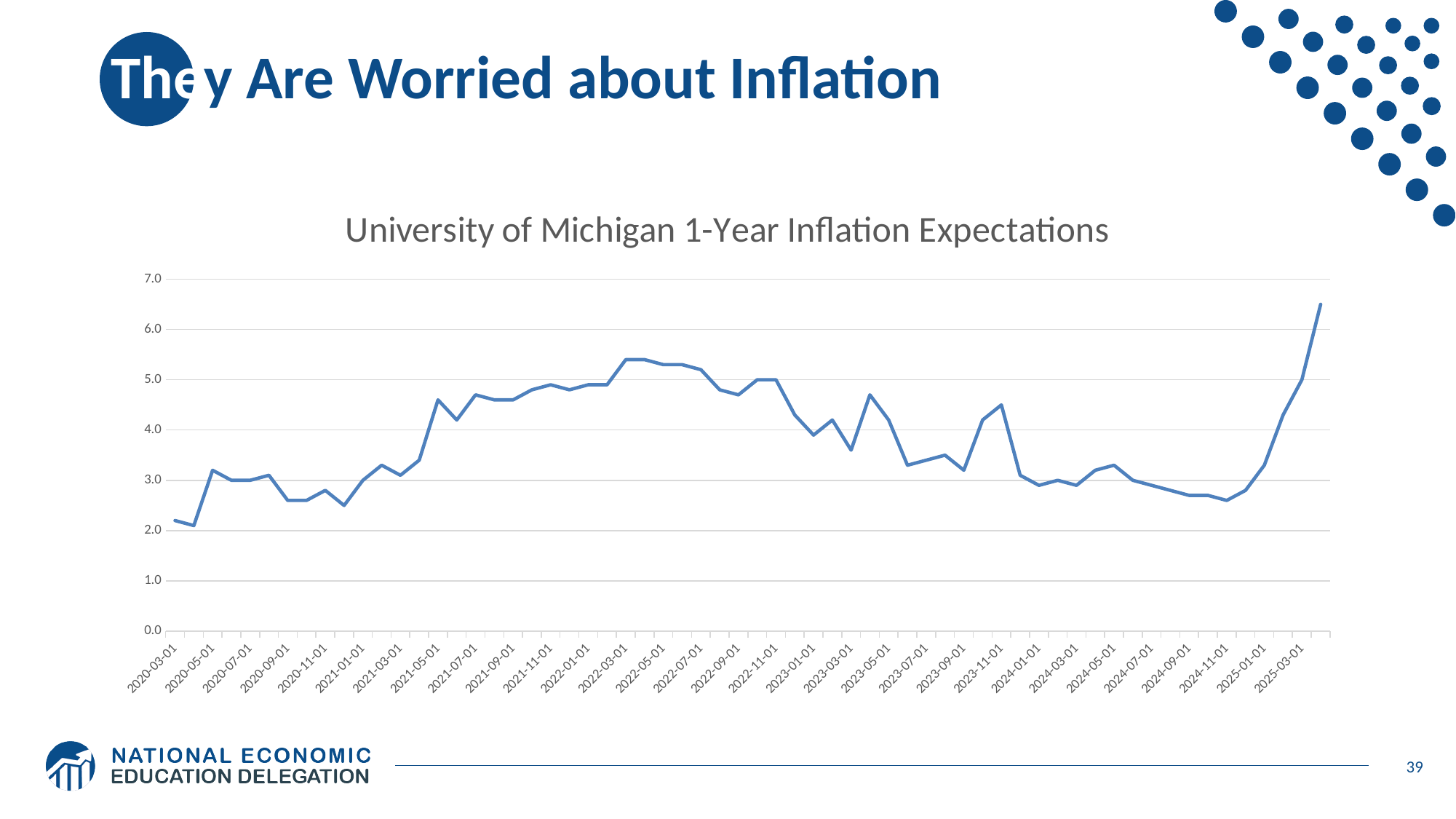
Is the value for 2024-11-01 greater or less than 3.0? less Which is larger, the value for 2020-03-01 or the value for 2021-05-01? 2021-05-01 What is the title of the chart? University of Michigan 1-Year Inflation Expectations Is the value for 2022-03-01 greater or less than 5.0? greater Which is larger, the value for 2022-03-01 or the value for 2024-03-01? 2022-03-01 What kind of chart is shown on the slide? line chart Do the values rise or fall from 2024-11-01 to the end of the line? rise Is the value at the last point of the line (after 2025-03-01) greater or less than 6.0? greater What is the highest value shown on the vertical axis of the chart? 7.0